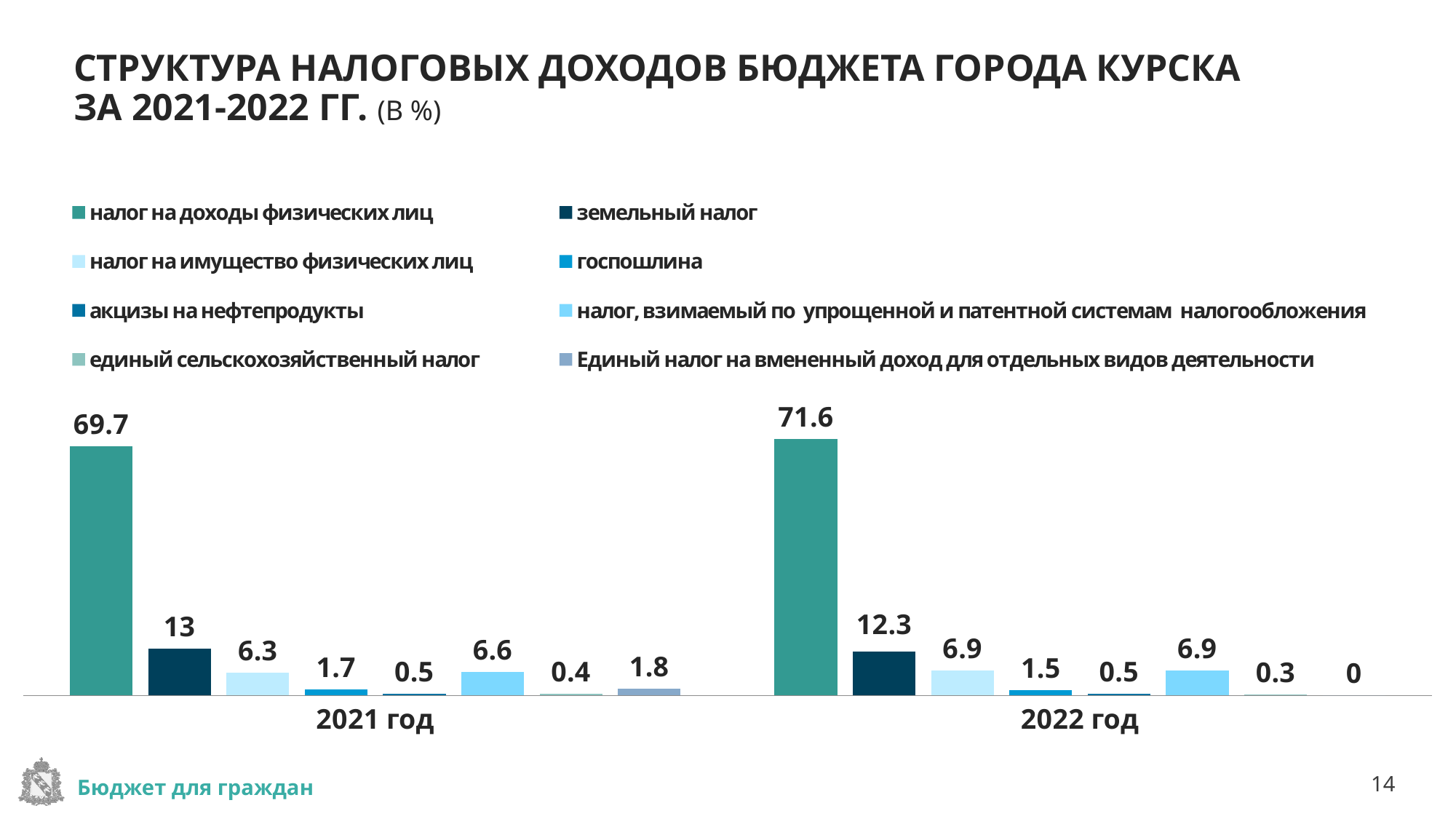
Which is larger: земельный налог in 2021 год or земельный налог in 2022 год? земельный налог in 2021 год What kind of chart is shown on the slide? bar chart Which series has the lowest value in 2022 год? Единый налог на вмененный доход для отдельных видов деятельности How many year categories are shown on the x axis? 2 What is the value for Единый налог на вмененный доход для отдельных видов деятельности in 2021 год? 1.8 What is the value for налог на имущество физических лиц in 2022 год? 6.9 What is the value for земельный налог in 2022 год? 12.3 Which series has the highest value in 2022 год? налог на доходы физических лиц What is the value for налог на доходы физических лиц in 2021 год? 69.7 What is the value for госпошлина in 2022 год? 1.5 What is the difference between the values for налог на доходы физических лиц in 2022 год and 2021 год? 1.9 How many series does the legend list? 8